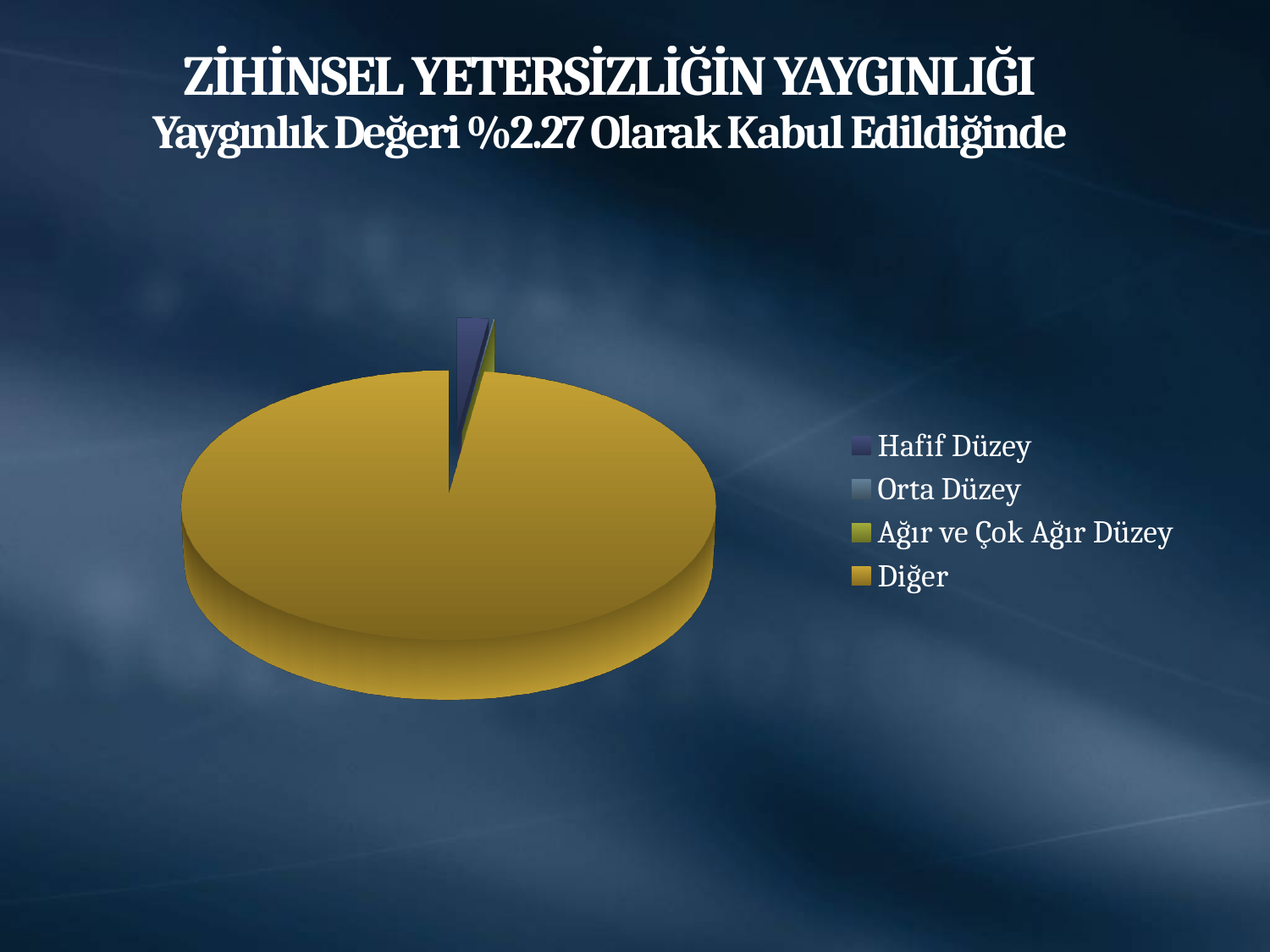
Does the Diğer slice take up more or less than half of the pie chart? more Which category is listed first in the legend of the pie chart? Hafif Düzey How many categories does the legend of the pie chart list? 4 Which category has the largest slice in the pie chart? Diğer Which is larger in the pie chart, the slice for Diğer or the slice for Hafif Düzey? Diğer What colour is the Diğer slice in the pie chart? gold/yellow What kind of chart is shown on the slide? pie chart